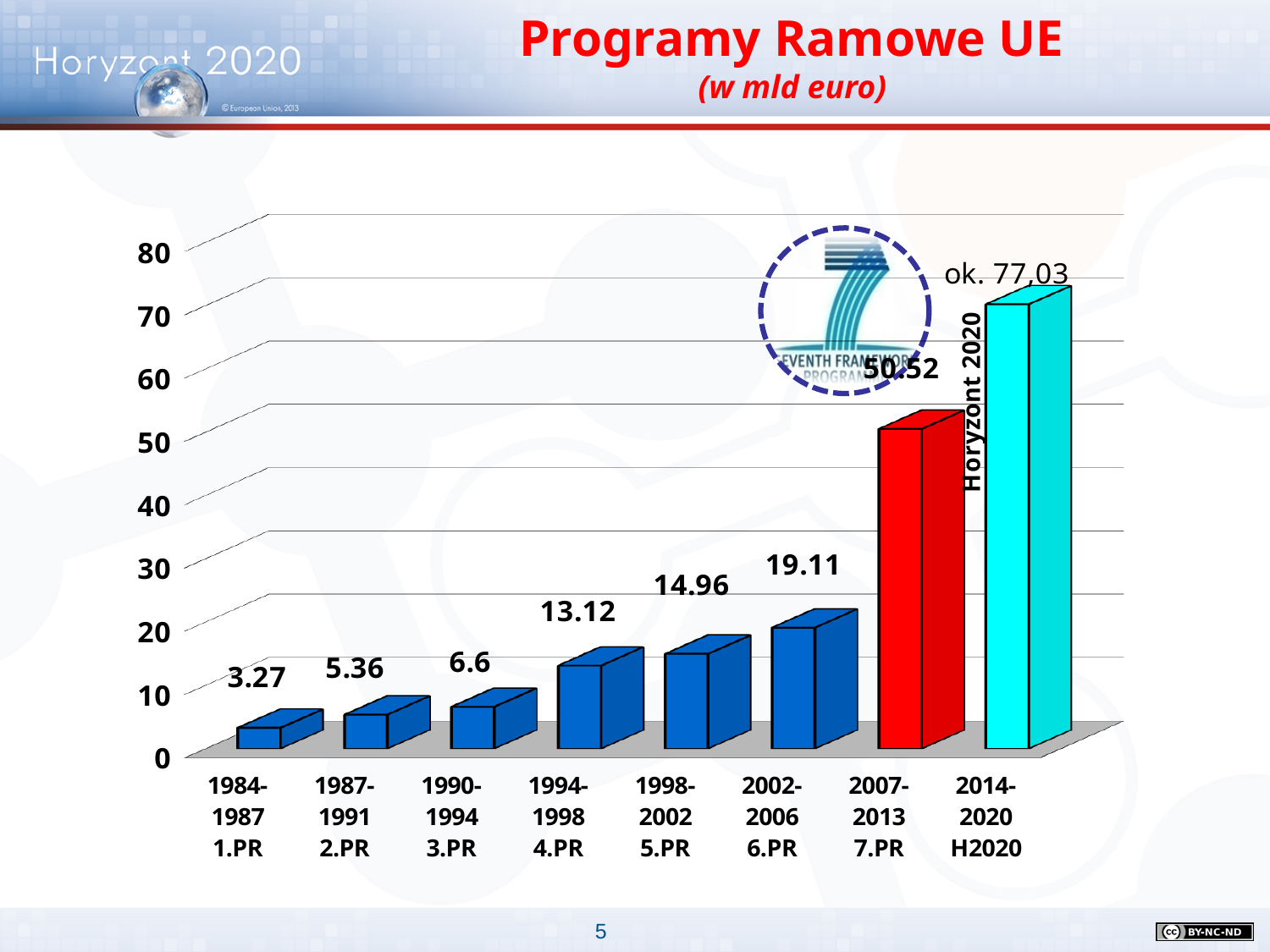
What is the difference between the values for 2007-2013 7.PR and 2002-2006 6.PR? 31.41 What is the value for 1994-1998 4.PR? 13.12 What is the value for 1984-1987 1.PR? 3.27 Which programme has the highest value? 2014-2020 H2020 What colour is the bar for 2007-2013 7.PR? red Is the value for 2014-2020 H2020 greater or less than 70? greater How many programmes (bars) are shown in the chart? 8 What kind of chart is shown on the slide? bar chart Do the values rise or fall from 1.PR to H2020 along the x axis? rise Which programme has the lowest value? 1984-1987 1.PR What is the value for 2007-2013 7.PR? 50.52 Which is larger, the value for 1998-2002 5.PR or 1990-1994 3.PR? 1998-2002 5.PR